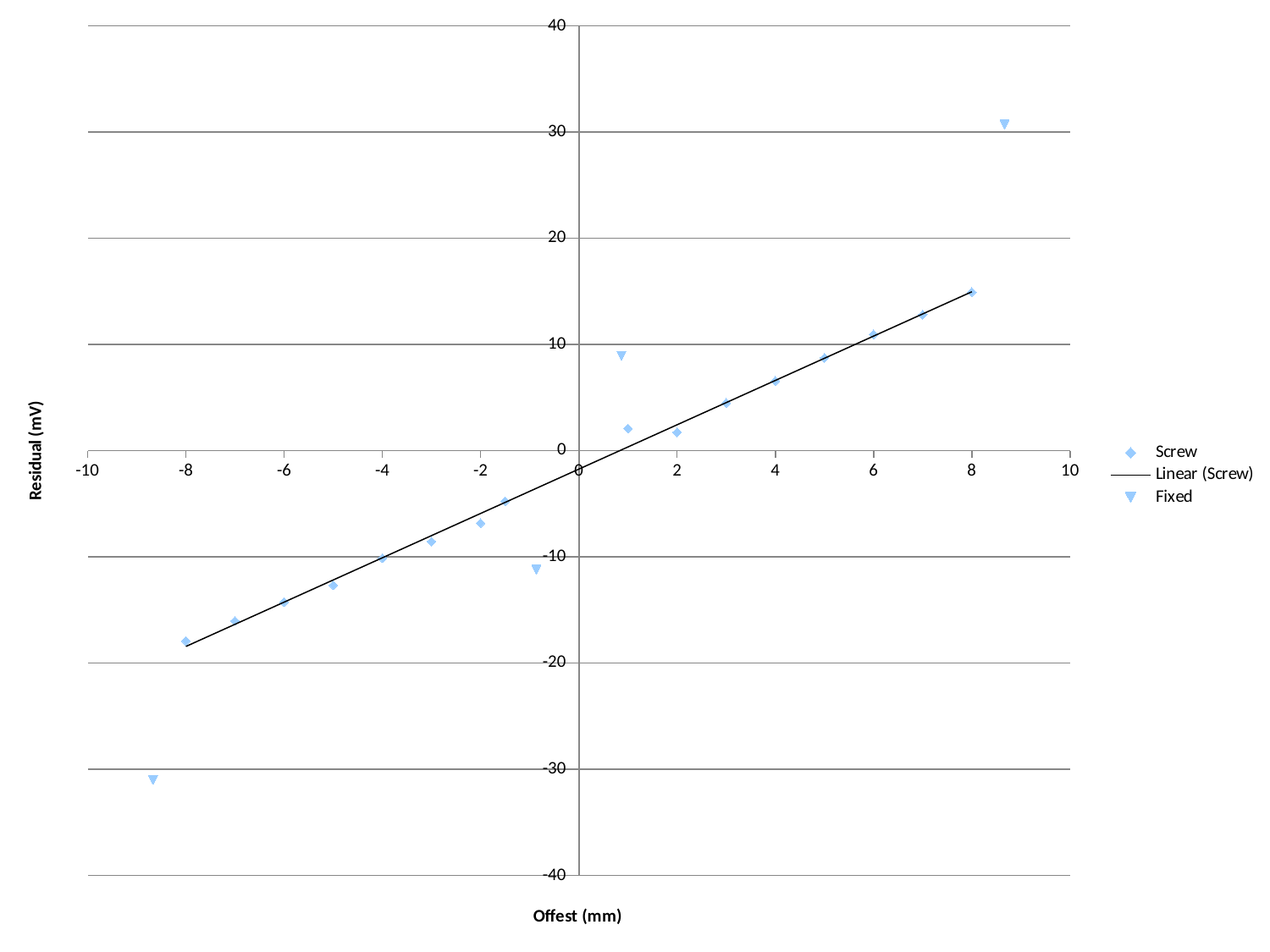
What kind of chart is shown on the slide? scatter chart Do the Screw values rise or fall as the offset increases along the x axis? rise Which is larger, the Screw value at an offset of 8 mm or the Screw value at an offset of -8 mm? 8 mm Is the Screw value at an offset of 8 mm greater or less than 10? greater Is the Fixed point plotted near an offset of -9 mm greater or less than -20? less Is the Fixed point plotted near an offset of 9 mm greater or less than 20? greater How many entries does the legend list? 3 At which offset does the Screw series reach its highest residual? 8 What is the title of the vertical axis? Residual (mV) How many Fixed data points are plotted? 4 What are the entries listed in the legend? Screw, Linear (Screw), Fixed